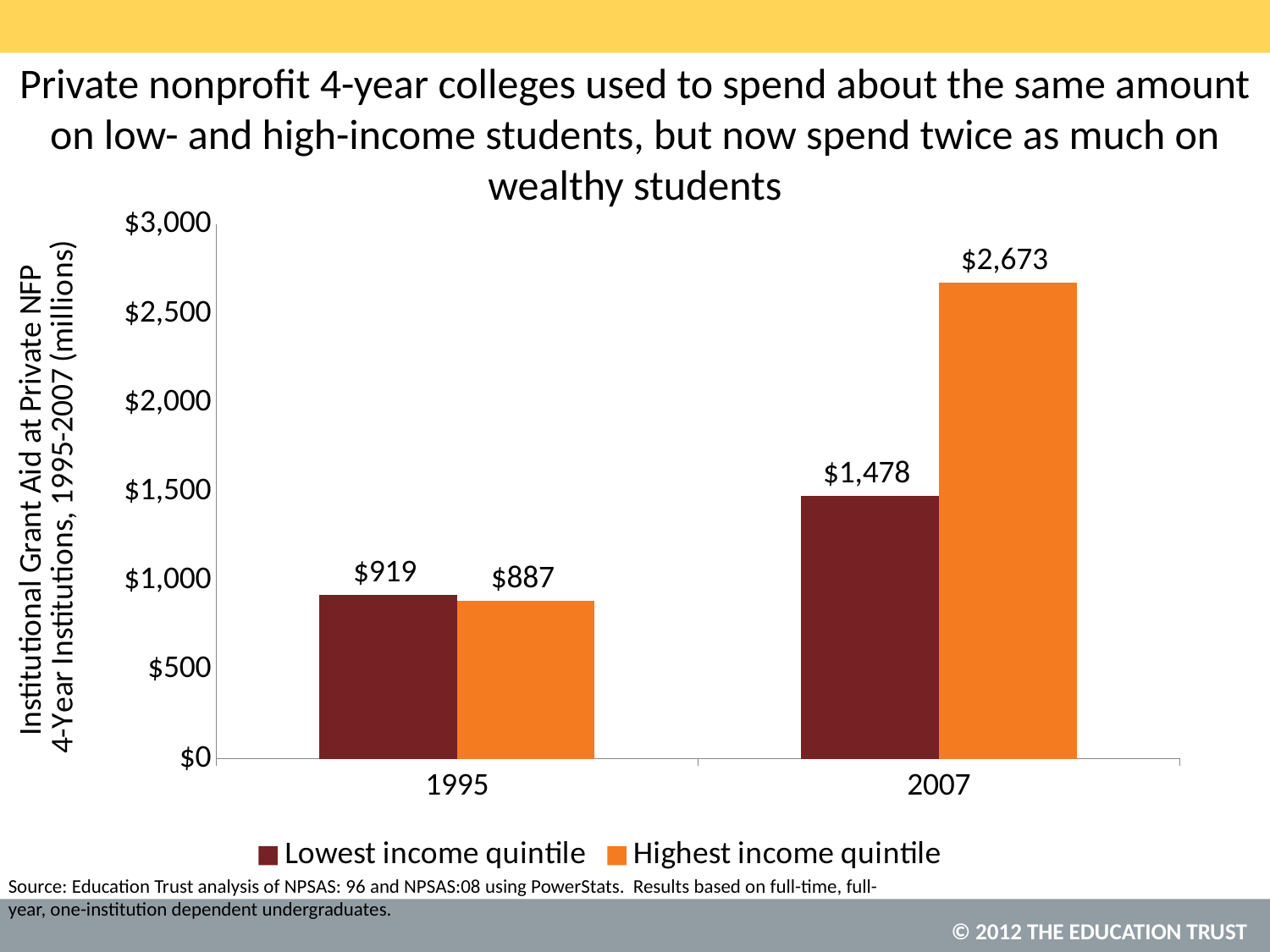
What is the value for the Lowest income quintile in 2007? $1,478 What is the difference between the Highest income quintile and the Lowest income quintile in 2007? $1,195 What is the value for the Lowest income quintile in 1995? $919 What is the value for the Highest income quintile in 2007? $2,673 How many series does the legend list? 2 What kind of chart is shown on the slide? Bar chart What is the value for the Highest income quintile in 1995? $887 In 1995, which is larger: the Lowest income quintile or the Highest income quintile? Lowest income quintile Which bar has the lowest value on the chart? Highest income quintile in 1995 Which bar has the highest value on the chart? Highest income quintile in 2007 How many years are shown on the x axis? 2 Is the value for the Highest income quintile in 2007 greater or less than $2,500? greater